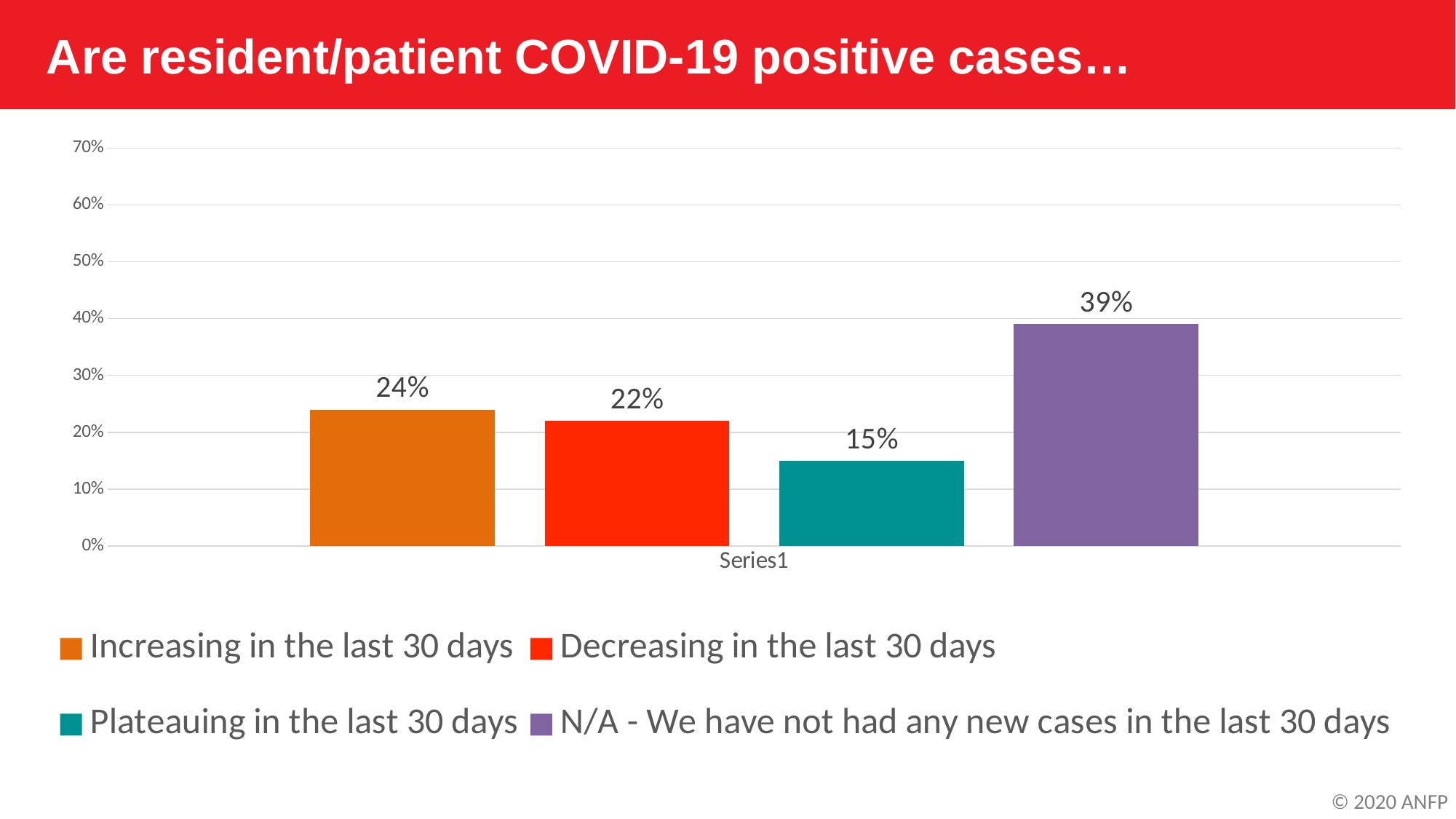
What colour is the bar for 'Plateauing in the last 30 days'? Teal Which response has the highest percentage? N/A - We have not had any new cases in the last 30 days What percentage of respondents said COVID-19 positive cases are plateauing in the last 30 days? 15% Which response has the lowest percentage? Plateauing in the last 30 days What percentage of respondents selected 'N/A - We have not had any new cases in the last 30 days'? 39% How many response categories are shown in the chart? 4 What is the difference in percentage points between 'Increasing in the last 30 days' and 'Plateauing in the last 30 days'? 9% What percentage of respondents said COVID-19 positive cases are decreasing in the last 30 days? 22% Which is larger: the percentage for 'Increasing in the last 30 days' or 'Decreasing in the last 30 days'? Increasing in the last 30 days What is the difference in percentage points between 'N/A - We have not had any new cases in the last 30 days' and 'Increasing in the last 30 days'? 15% What percentage of respondents said COVID-19 positive cases are increasing in the last 30 days? 24% What type of chart is shown on the slide? Bar chart